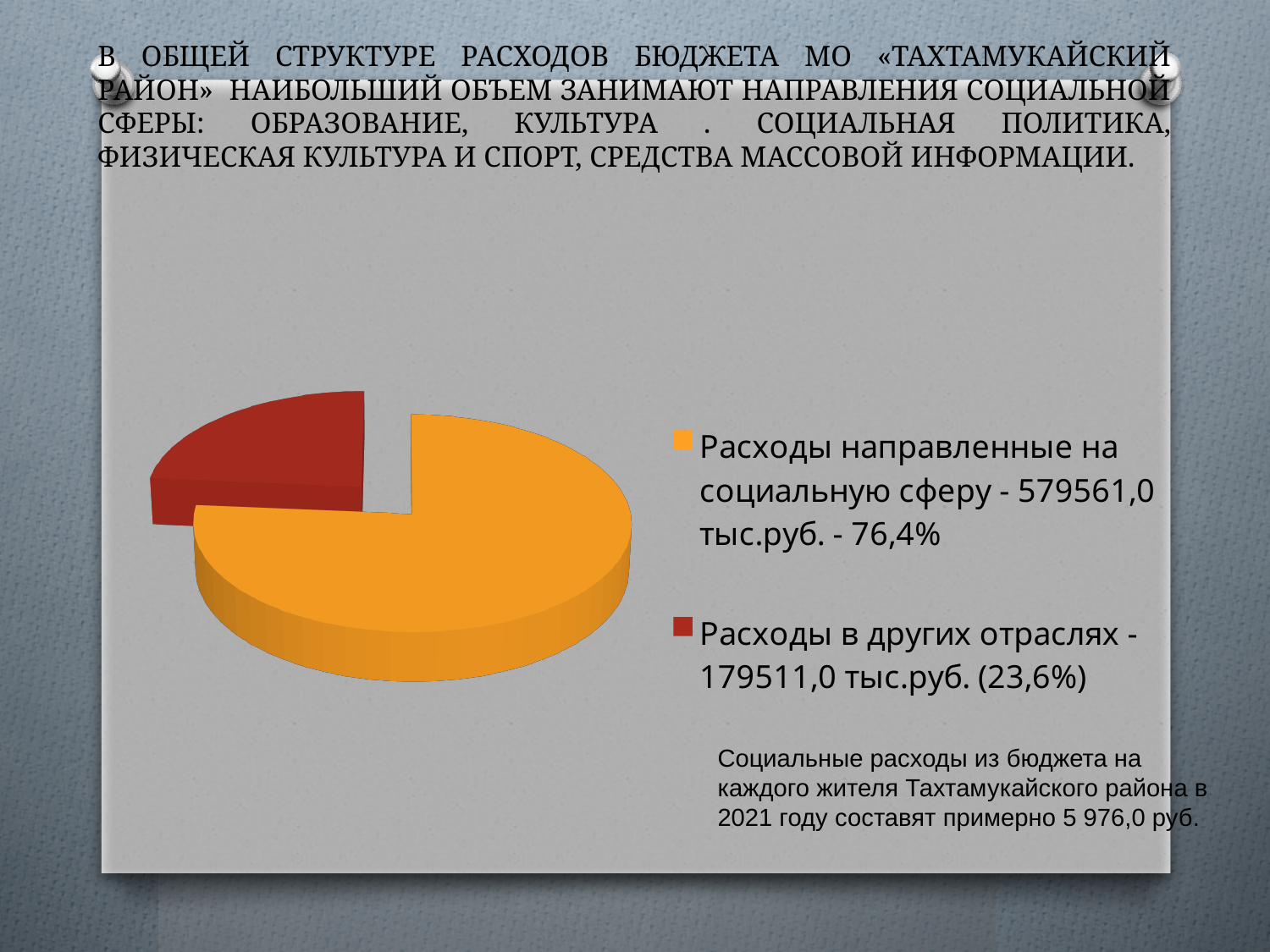
Which is larger: "Расходы направленные на социальную сферу" or "Расходы в других отраслях"? Расходы направленные на социальную сферу What colour is the slice for "Расходы в других отраслях" in the pie chart? Red What is the difference between "Расходы направленные на социальную сферу" and "Расходы в других отраслях" in тыс.руб.? 400050,0 тыс.руб. How many entries does the legend of the pie chart list? 2 What share of the pie does "Расходы направленные на социальную сферу" take? 76,4% What is the value for "Расходы направленные на социальную сферу" in the pie chart? 579561,0 тыс.руб. Which slice of the pie chart is the smallest? Расходы в других отраслях What share of the pie does "Расходы в других отраслях" take? 23,6% What is the value for "Расходы в других отраслях" in the pie chart? 179511,0 тыс.руб. Which slice of the pie chart is the largest? Расходы направленные на социальную сферу What kind of chart is shown on the slide? Pie chart How many slices does the pie chart have? 2